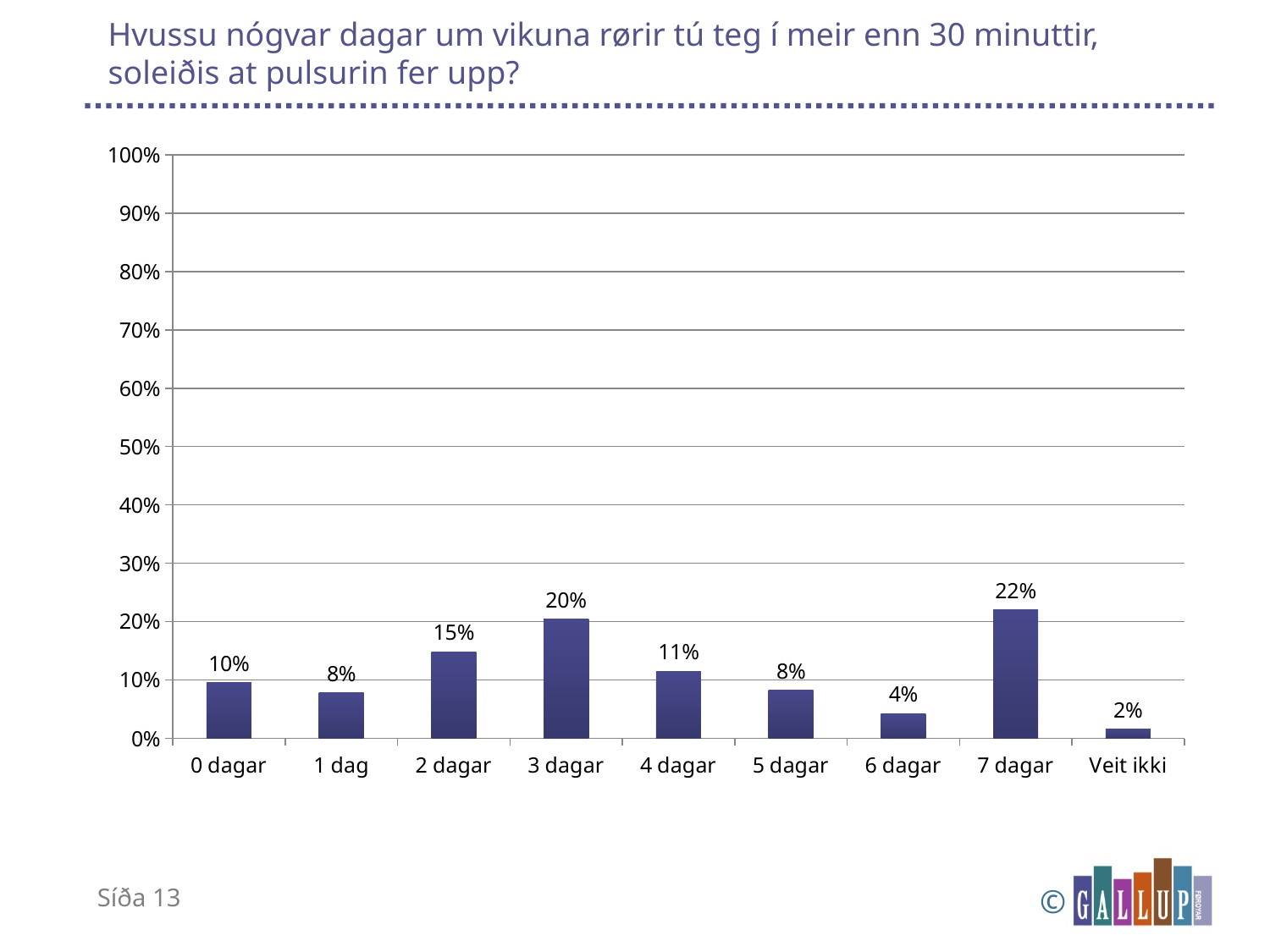
What is the value for 7 dagar? 22% Which category has the highest value? 7 dagar Which category has the lowest value? Veit ikki What is the value for Veit ikki? 2% Is the value for 2 dagar greater or less than 10%? greater What is the difference between the values for 2 dagar and 6 dagar? 11% What is the value for 3 dagar? 20% What is the difference between the values for 7 dagar and 3 dagar? 2% What is the value for 0 dagar? 10% What kind of chart is shown on the slide? bar chart Which is larger, the value for 4 dagar or the value for 5 dagar? 4 dagar How many categories are shown on the x axis? 9